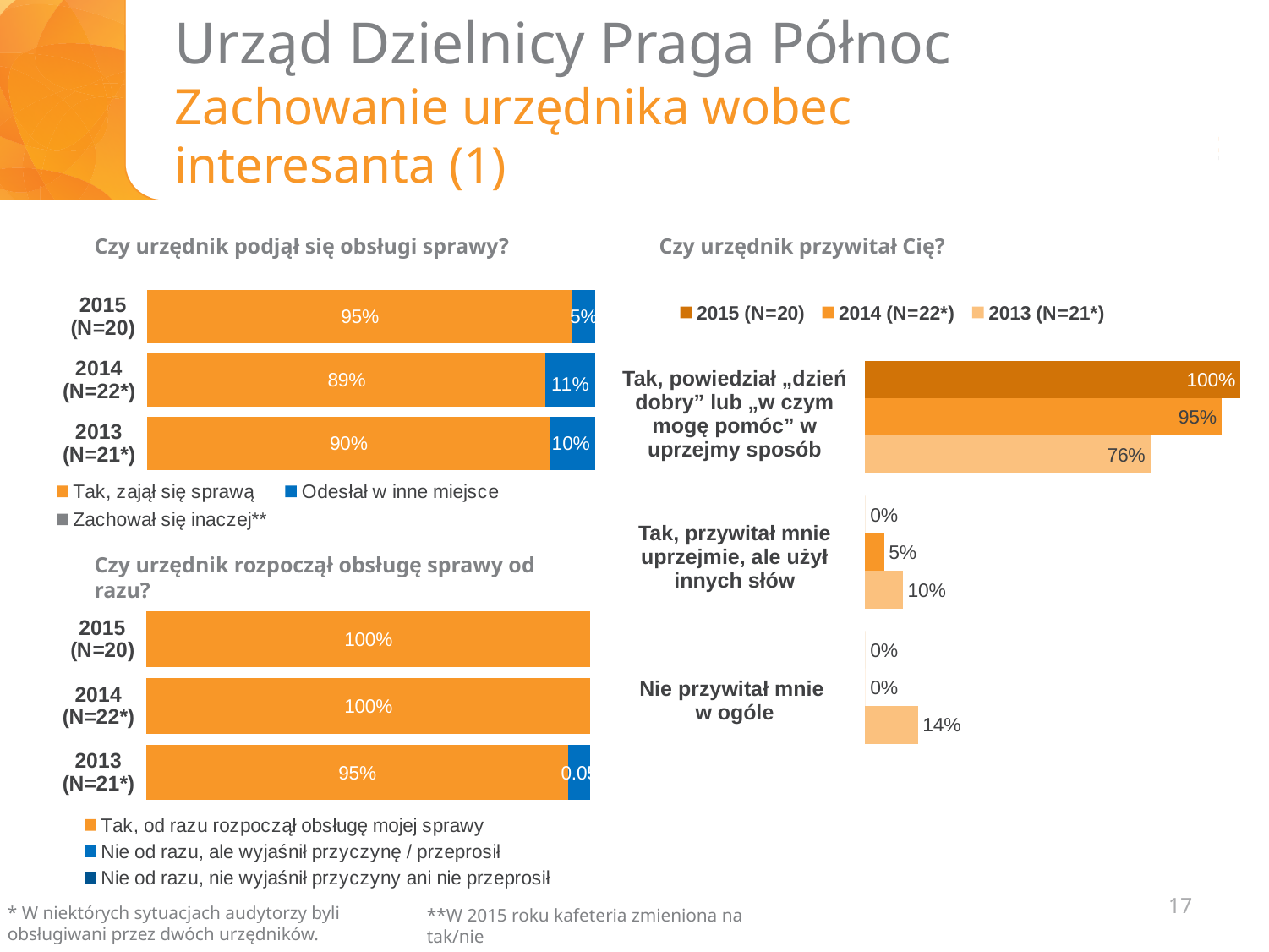
In the chart "Czy urzędnik przywitał Cię?", what is the difference between the 2015 (N=20) and 2014 (N=22*) values for "Tak, powiedział „dzień dobry” lub „w czym mogę pomóc” w uprzejmy sposób"? 5 percentage points In the chart "Czy urzędnik przywitał Cię?", what is the 2013 (N=21*) value for "Nie przywitał mnie w ogóle"? 14% In the chart "Czy urzędnik przywitał Cię?", what is the 2013 (N=21*) value for "Tak, powiedział „dzień dobry” lub „w czym mogę pomóc” w uprzejmy sposób"? 76% In the chart "Czy urzędnik przywitał Cię?", which is larger for "Tak, przywitał mnie uprzejmie, ale użył innych słów": the 2014 (N=22*) value or the 2013 (N=21*) value? 2013 (N=21*) In the chart "Czy urzędnik podjął się obsługi sprawy?", what is the difference between the "Tak, zajął się sprawą" values for 2015 (N=20) and 2014 (N=22*)? 6 percentage points In the chart "Czy urzędnik podjął się obsługi sprawy?", what is the value of "Odesłał w inne miejsce" for 2014 (N=22*)? 11% In the chart "Czy urzędnik podjął się obsługi sprawy?", what percentage for 2015 (N=20) corresponds to "Tak, zajął się sprawą"? 95% In the chart "Czy urzędnik rozpoczął obsługę sprawy od razu?", what is the value of "Tak, od razu rozpoczął obsługę mojej sprawy" for 2013 (N=21*)? 95% In the chart "Czy urzędnik podjął się obsługi sprawy?", which year has the highest share of "Tak, zajął się sprawą"? 2015 (N=20) How many series does the legend of the chart "Czy urzędnik podjął się obsługi sprawy?" list? 3 What type of chart is "Czy urzędnik przywitał Cię?"? Bar chart In the chart "Czy urzędnik rozpoczął obsługę sprawy od razu?", which year has the lowest share of "Tak, od razu rozpoczął obsługę mojej sprawy"? 2013 (N=21*)